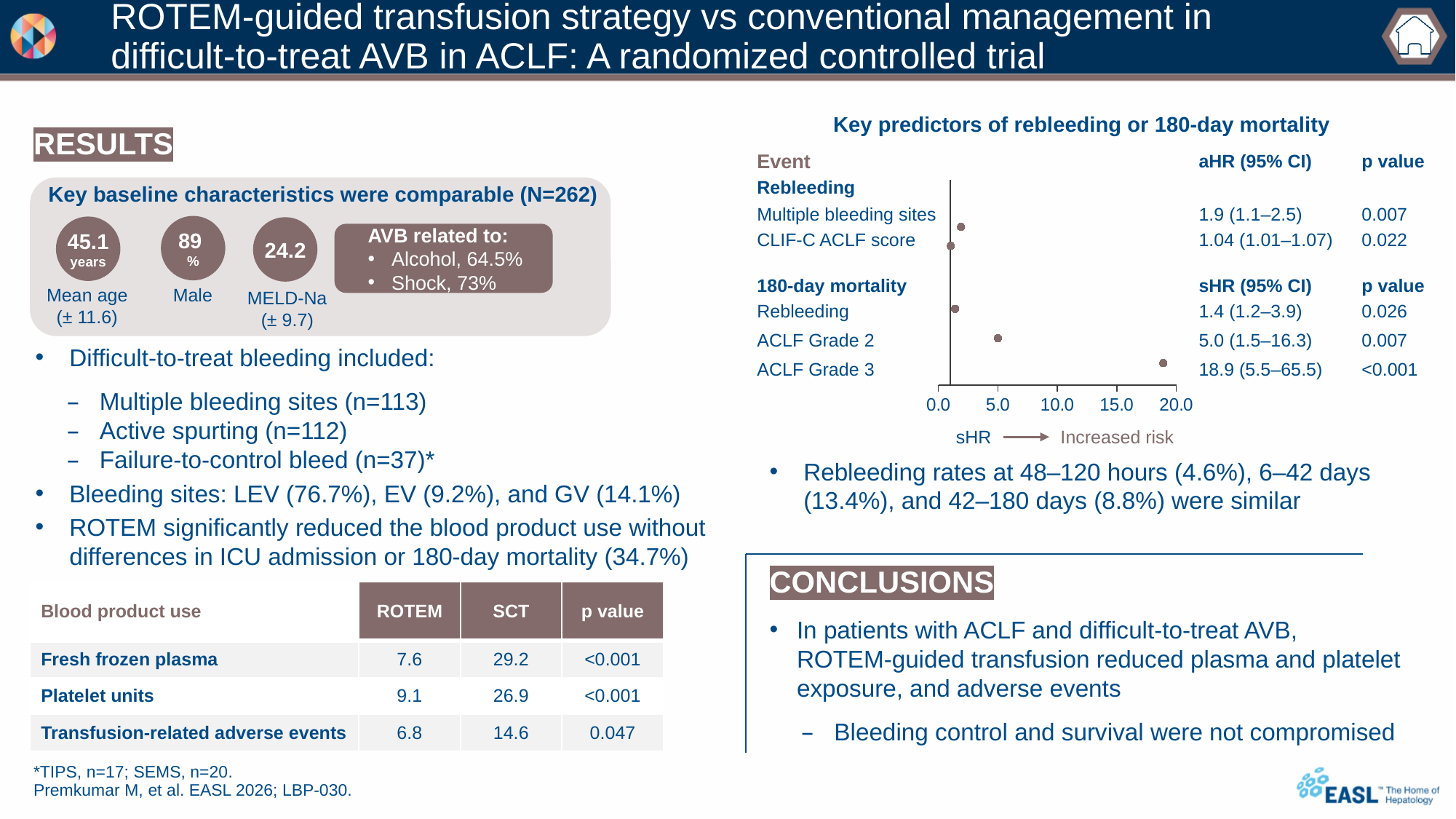
In the 'Key predictors of rebleeding or 180-day mortality' chart, which predictor has the lowest hazard ratio? CLIF-C ACLF score In the 'Key predictors of rebleeding or 180-day mortality' chart, which has a larger sHR: ACLF Grade 2 or ACLF Grade 3? ACLF Grade 3 In the 'Key predictors of rebleeding or 180-day mortality' chart, is the sHR for ACLF Grade 3 greater or less than 15.0? greater In the 'Key predictors of rebleeding or 180-day mortality' chart, what is the aHR for Multiple bleeding sites? 1.9 (1.1–2.5) In the 'Key predictors of rebleeding or 180-day mortality' chart, is the sHR for ACLF Grade 2 greater or less than 10.0? less How many predictors are plotted as points in the 'Key predictors of rebleeding or 180-day mortality' chart? 5 In the 'Key predictors of rebleeding or 180-day mortality' chart, which predictor has the highest hazard ratio? ACLF Grade 3 In the 'Key predictors of rebleeding or 180-day mortality' chart, what is the sHR for ACLF Grade 3? 18.9 (5.5–65.5) What is the title of the chart on the right side of the slide? Key predictors of rebleeding or 180-day mortality What is the highest tick value shown on the x axis of the 'Key predictors of rebleeding or 180-day mortality' chart? 20.0 In the 'Key predictors of rebleeding or 180-day mortality' chart, what is the sHR for ACLF Grade 2? 5.0 (1.5–16.3) In the 'Key predictors of rebleeding or 180-day mortality' chart, what is the difference between the sHR point estimates for ACLF Grade 3 and ACLF Grade 2? 13.9